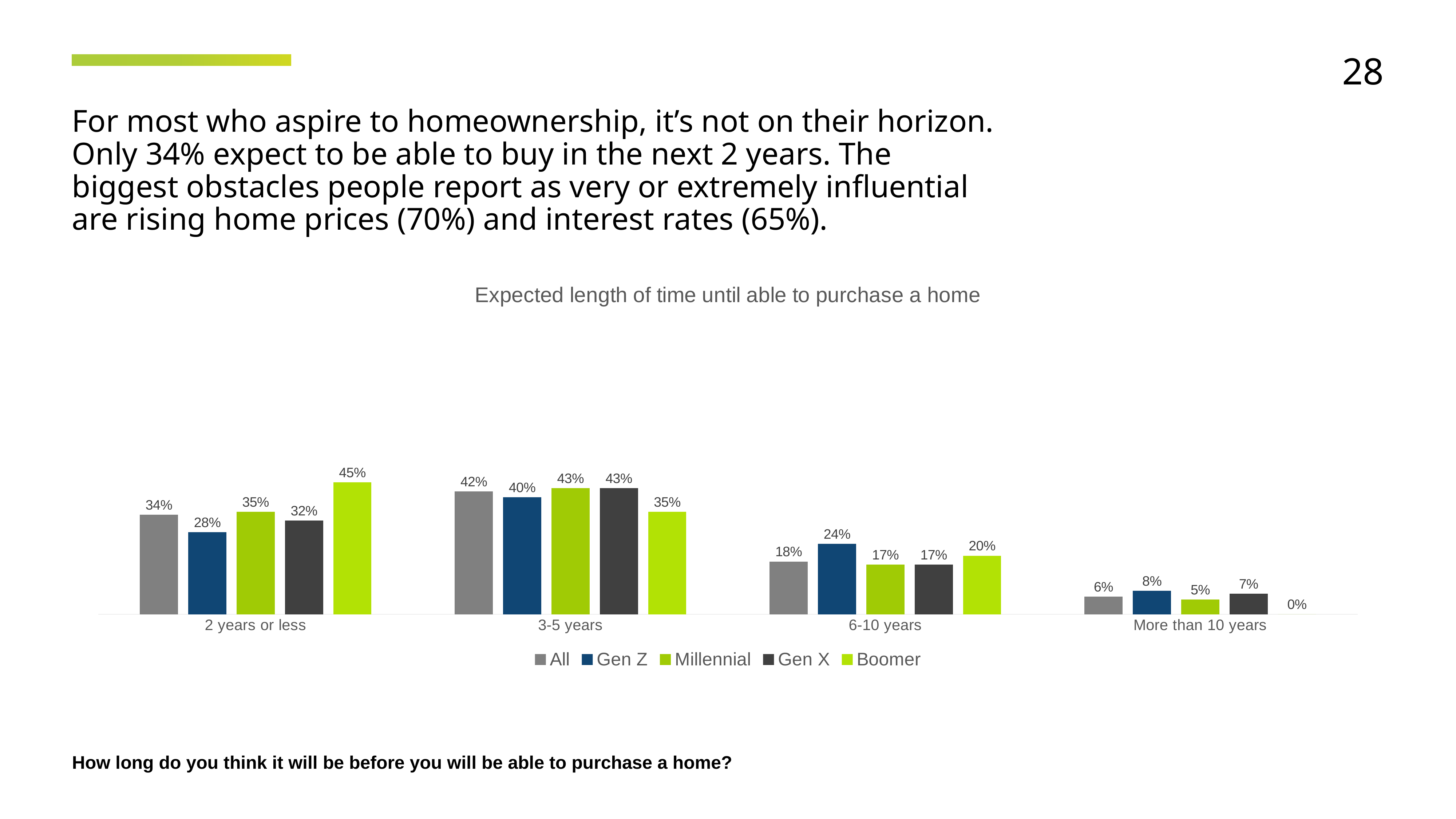
What is the value for Gen Z in the '3-5 years' category? 40% What is the value for Boomer in the '2 years or less' category? 45% What is the title of the chart? Expected length of time until able to purchase a home What is the value for All in the '6-10 years' category? 18% How many series does the legend list? 5 What kind of chart is shown on the slide? Bar chart How many categories are shown on the x axis? 4 Which series has the lowest value in the 'More than 10 years' category? Boomer What is the difference between the Boomer and Gen Z values in the '2 years or less' category? 17% Which series has the highest value in the '2 years or less' category? Boomer What is the value for Boomer in the 'More than 10 years' category? 0% Which is larger in the '6-10 years' category: Gen Z or Boomer? Gen Z